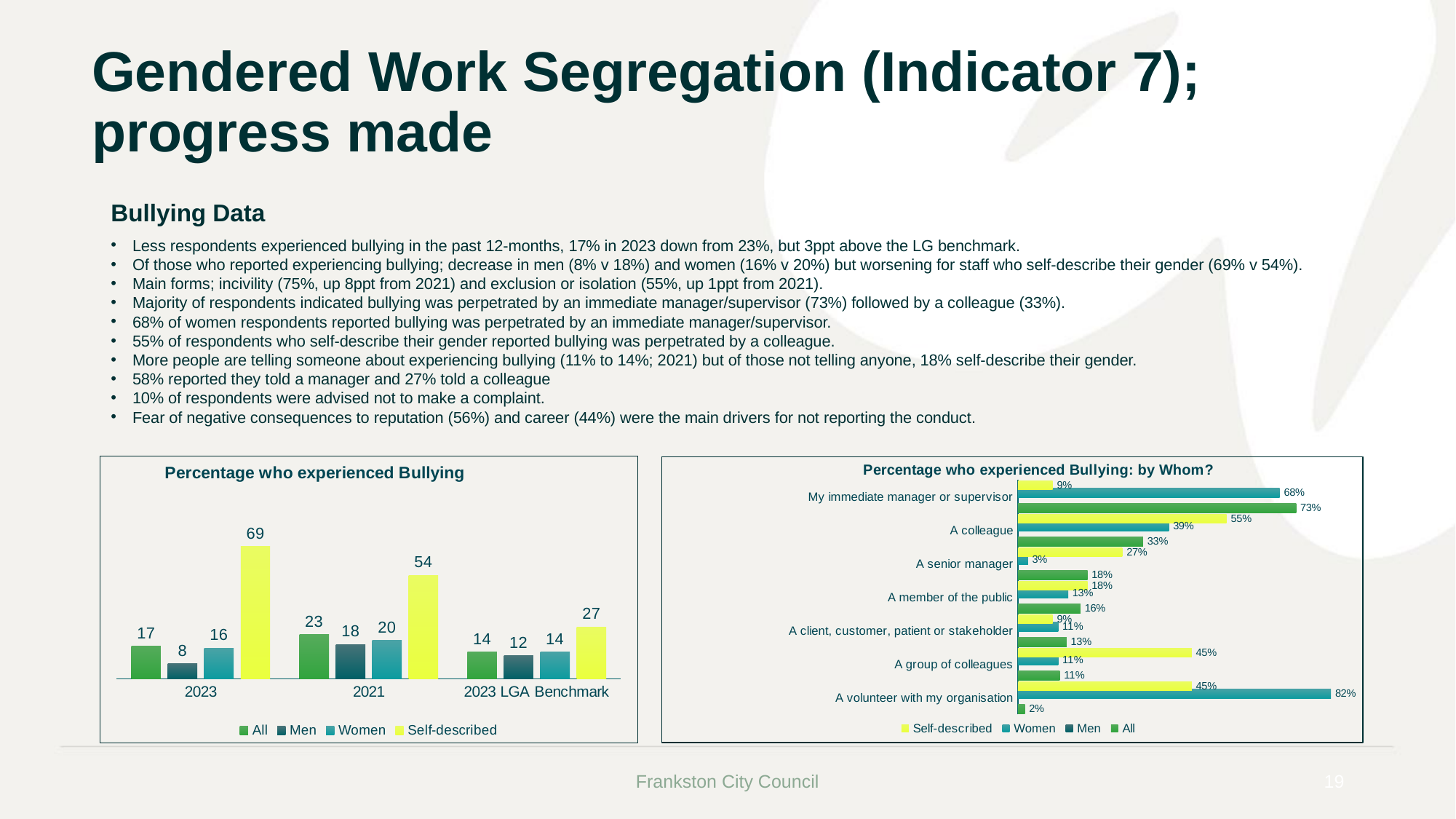
On the 'Percentage who experienced Bullying' chart, what is the difference between the Self-described values for 2023 and 2021? 15 On the 'Percentage who experienced Bullying' chart, what is the value for All in the 2023 LGA Benchmark? 14 On the 'Percentage who experienced Bullying' chart, what is the value for Self-described in 2023? 69 On the 'Percentage who experienced Bullying' chart, is the All value larger in 2023 or in 2021? 2021 On the 'Percentage who experienced Bullying' chart, what is the value for Men in 2021? 18 On the 'Percentage who experienced Bullying' chart, how many series does the legend list? 4 What kind of chart is 'Percentage who experienced Bullying: by Whom?'? Bar chart On the 'Percentage who experienced Bullying: by Whom?' chart, what is the Women value for 'A volunteer with my organisation'? 82% On the 'Percentage who experienced Bullying: by Whom?' chart, what is the All value for 'My immediate manager or supervisor'? 73% On the 'Percentage who experienced Bullying' chart, how many categories are shown on the x axis? 3 On the 'Percentage who experienced Bullying: by Whom?' chart, what is the Self-described value for 'A colleague'? 55% On the 'Percentage who experienced Bullying' chart, which series has the lowest value in 2023? Men